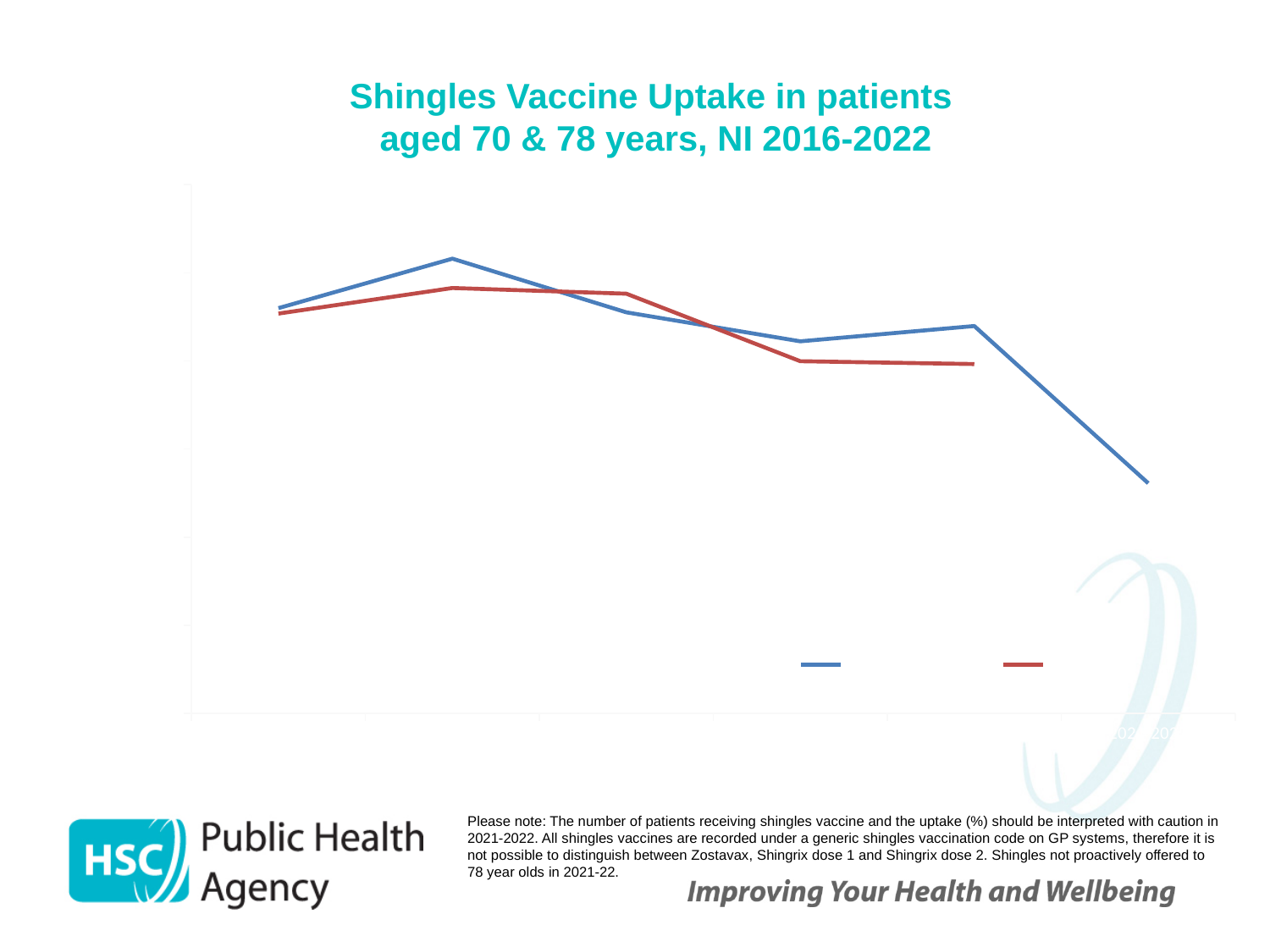
What is the title of the chart? Shingles Vaccine Uptake in patients aged 70 & 78 years, NI 2016-2022 What colours are the two lines on the chart? blue and red At the rightmost point of the red line, is the blue line above or below the red line? above Does the blue line end higher or lower than it starts? lower Which line reaches the highest point on the chart, the blue or the red? blue What kind of chart is shown on the slide? line chart How many series does the legend list? 2 How many data points does the blue line have? 6 How many data points does the red line have? 5 Does the red line end higher or lower than it starts? lower Which line reaches the lowest point on the chart, the blue or the red? blue